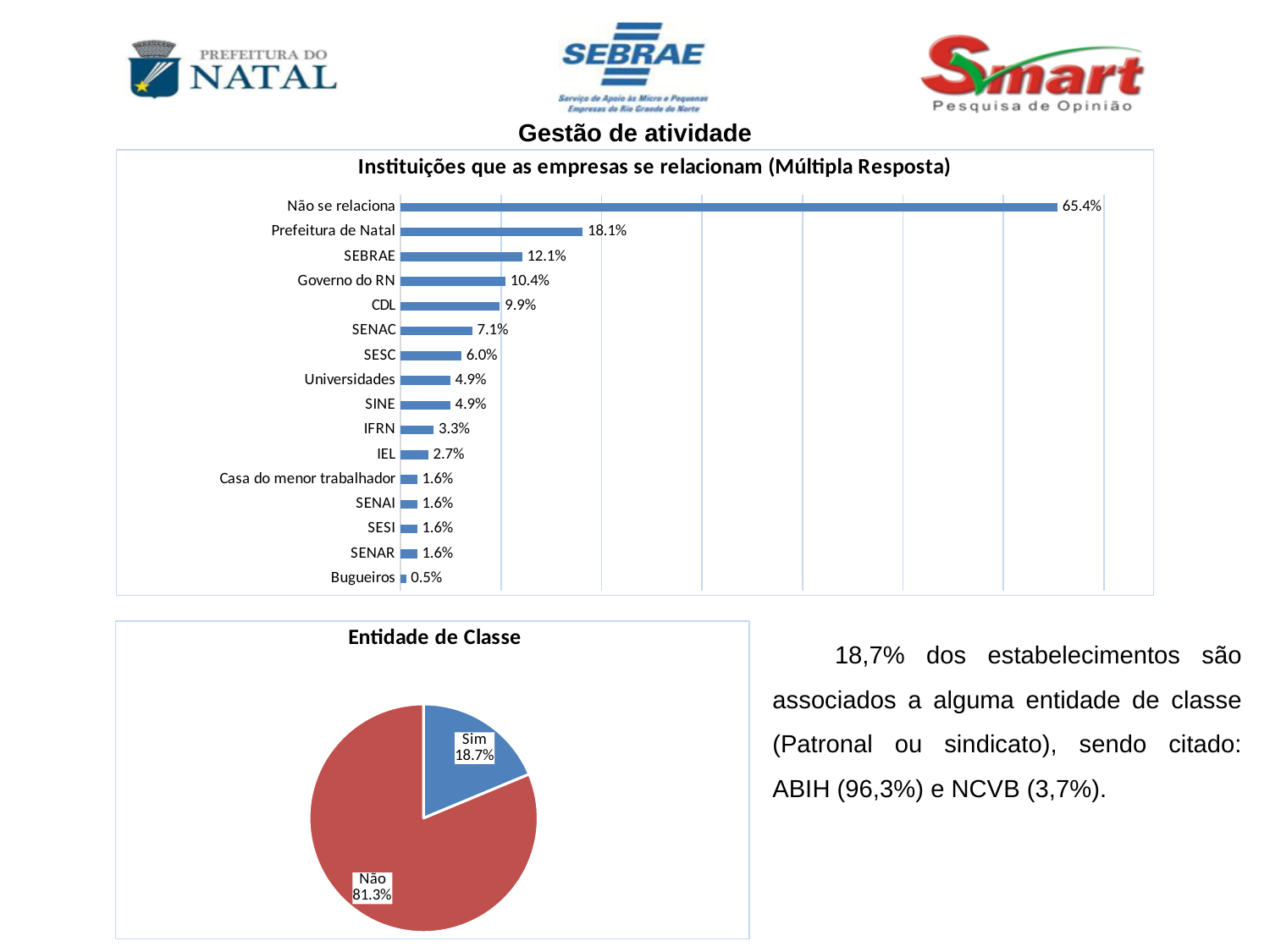
In the 'Instituições que as empresas se relacionam (Múltipla Resposta)' chart, which category has the lowest value? Bugueiros In the 'Instituições que as empresas se relacionam (Múltipla Resposta)' chart, what is the value for Governo do RN? 10.4% In the 'Entidade de Classe' chart, what is the value for 'Não'? 81.3% In the 'Instituições que as empresas se relacionam (Múltipla Resposta)' chart, which is larger, SENAC or SESC? SENAC How many categories are shown in the 'Instituições que as empresas se relacionam (Múltipla Resposta)' chart? 16 In the 'Instituições que as empresas se relacionam (Múltipla Resposta)' chart, which category has the highest value? Não se relaciona In the 'Entidade de Classe' chart, which slice is larger, 'Sim' or 'Não'? Não In the 'Instituições que as empresas se relacionam (Múltipla Resposta)' chart, what is the difference between Prefeitura de Natal and SEBRAE? 6.0% What kind of chart is 'Instituições que as empresas se relacionam (Múltipla Resposta)'? Bar chart In the 'Entidade de Classe' chart, what share does 'Sim' have? 18.7% What kind of chart is 'Entidade de Classe'? Pie chart In the 'Instituições que as empresas se relacionam (Múltipla Resposta)' chart, what is the value for SEBRAE? 12.1%